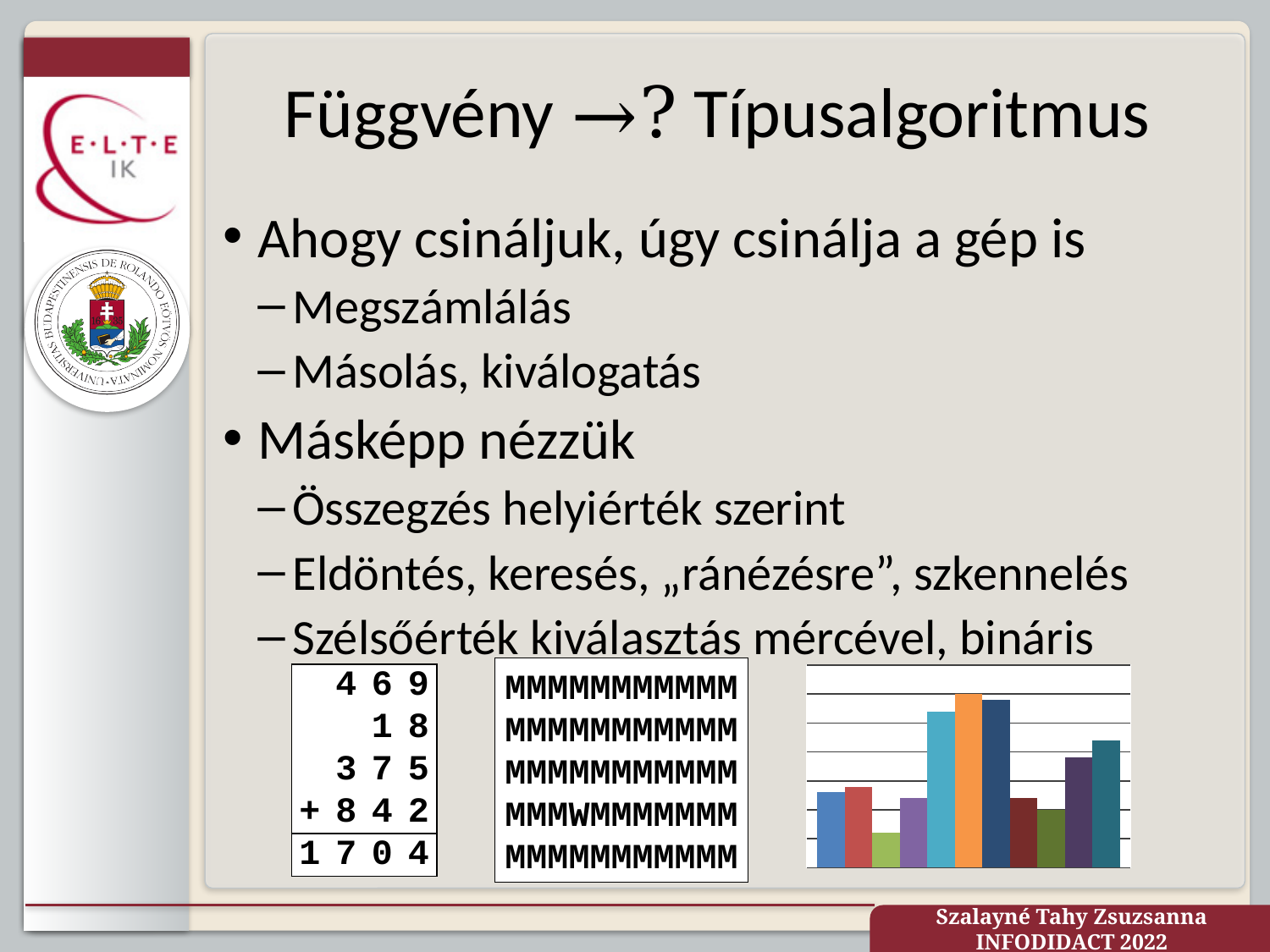
What kind of chart is shown at the bottom right of the slide? bar chart Does the bar chart at the bottom right show data labels on the bars? No In the bar chart at the bottom right, what colour is the shortest bar? green In the bar chart at the bottom right, which bar (by position from the left) is the tallest? the 6th bar In the bar chart at the bottom right, which is taller: the 2nd bar from the left or the 3rd bar from the left? the 2nd bar In the bar chart at the bottom right, which bar (by position from the left) is the shortest? the 3rd bar In the bar chart at the bottom right, which is taller: the 5th bar from the left or the 1st bar from the left? the 5th bar In the bar chart at the bottom right, what colour is the tallest bar? orange In the bar chart at the bottom right, which is taller: the 11th bar from the left or the 9th bar from the left? the 11th bar How many bars does the chart at the bottom right of the slide contain? 11 Does the bar chart at the bottom right have a legend? No